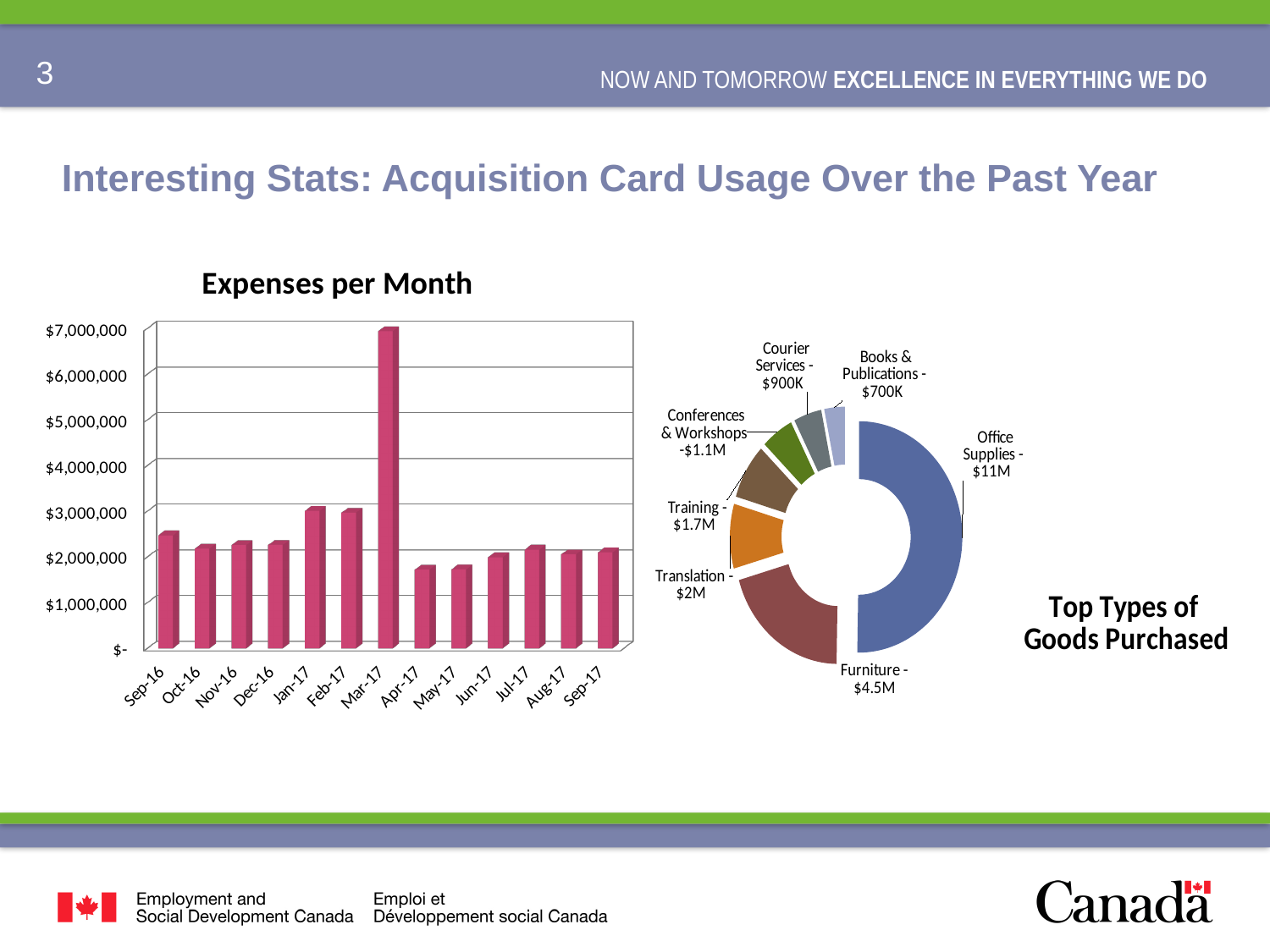
How many months are shown in the Expenses per Month chart? 13 In the Expenses per Month chart, which month has the highest expenses? Mar-17 In the Top Types of Goods Purchased chart, how much larger is Office Supplies than Furniture? $6.5M In the Top Types of Goods Purchased chart, which is larger: Translation or Training? Translation What kind of chart is the Top Types of Goods Purchased chart? Doughnut chart In the Top Types of Goods Purchased chart, what is the value for Furniture? $4.5M How many categories are shown in the Top Types of Goods Purchased chart? 7 In the Top Types of Goods Purchased chart, which category has the largest value? Office Supplies In the Top Types of Goods Purchased chart, which category has the smallest value? Books & Publications In the Top Types of Goods Purchased chart, what is the value for Office Supplies? $11M In the Top Types of Goods Purchased chart, what is the value for Courier Services? $900K In the Expenses per Month chart, is the value for Mar-17 greater or less than $6,000,000? greater